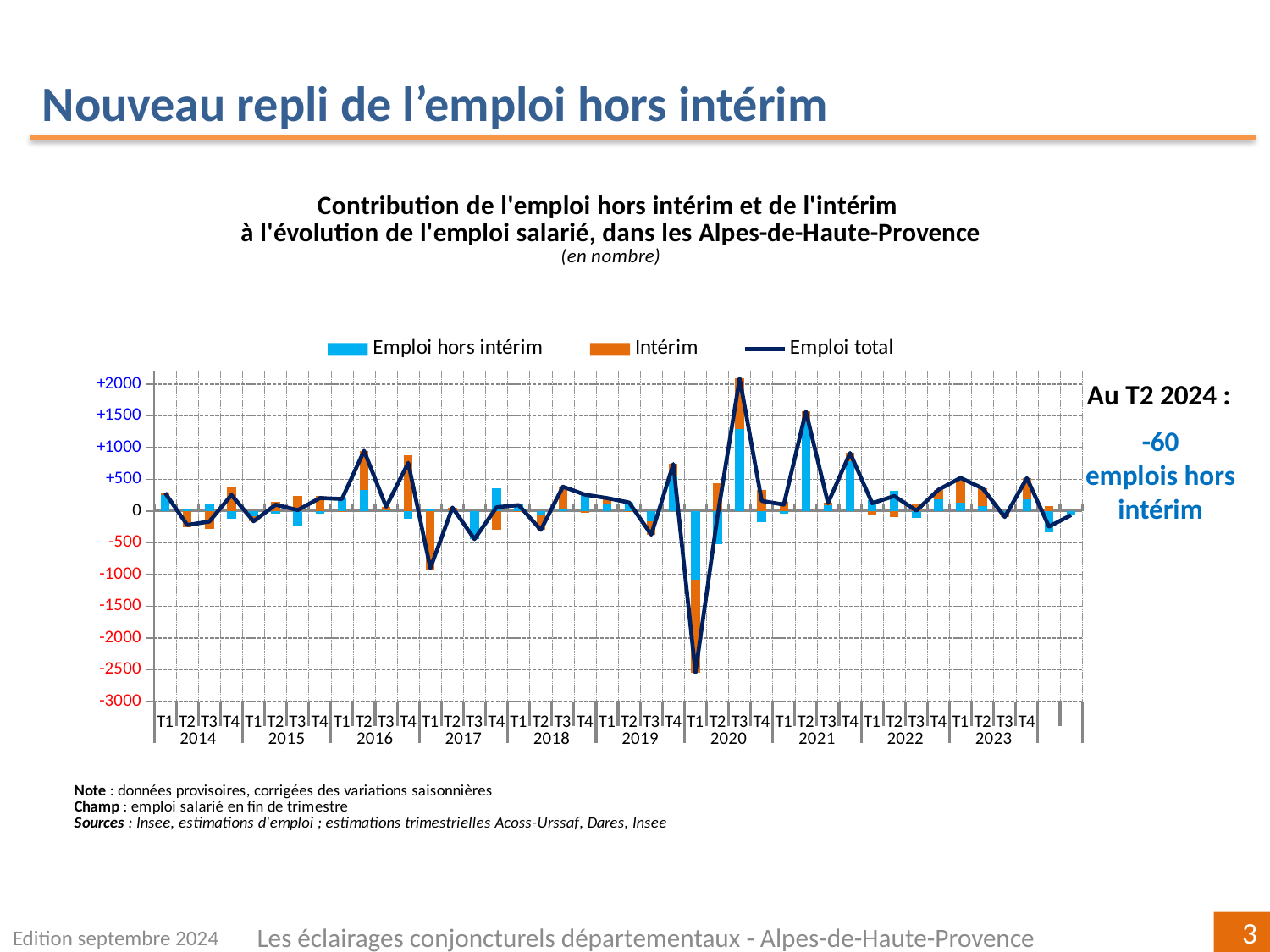
Is the Emploi total value for T3 2020 greater or less than +1500? greater In which quarter does Emploi total reach its highest value? T3 2020 Is the Emploi total value for T1 2020 greater or less than -2000? less What kind of chart is this? A combined bar and line chart Which series is drawn as a line rather than bars? Emploi total Which is larger, the Emploi total value in T3 2020 or in T2 2021? T3 2020 Is the Emploi total value for T2 2016 greater or less than +500? greater According to the annotation, what is the change in emploi hors intérim at T2 2024? -60 In which quarter does Emploi total reach its lowest value? T1 2020 How many series does the legend list? 3 What colour represents Emploi hors intérim in the chart? Light blue